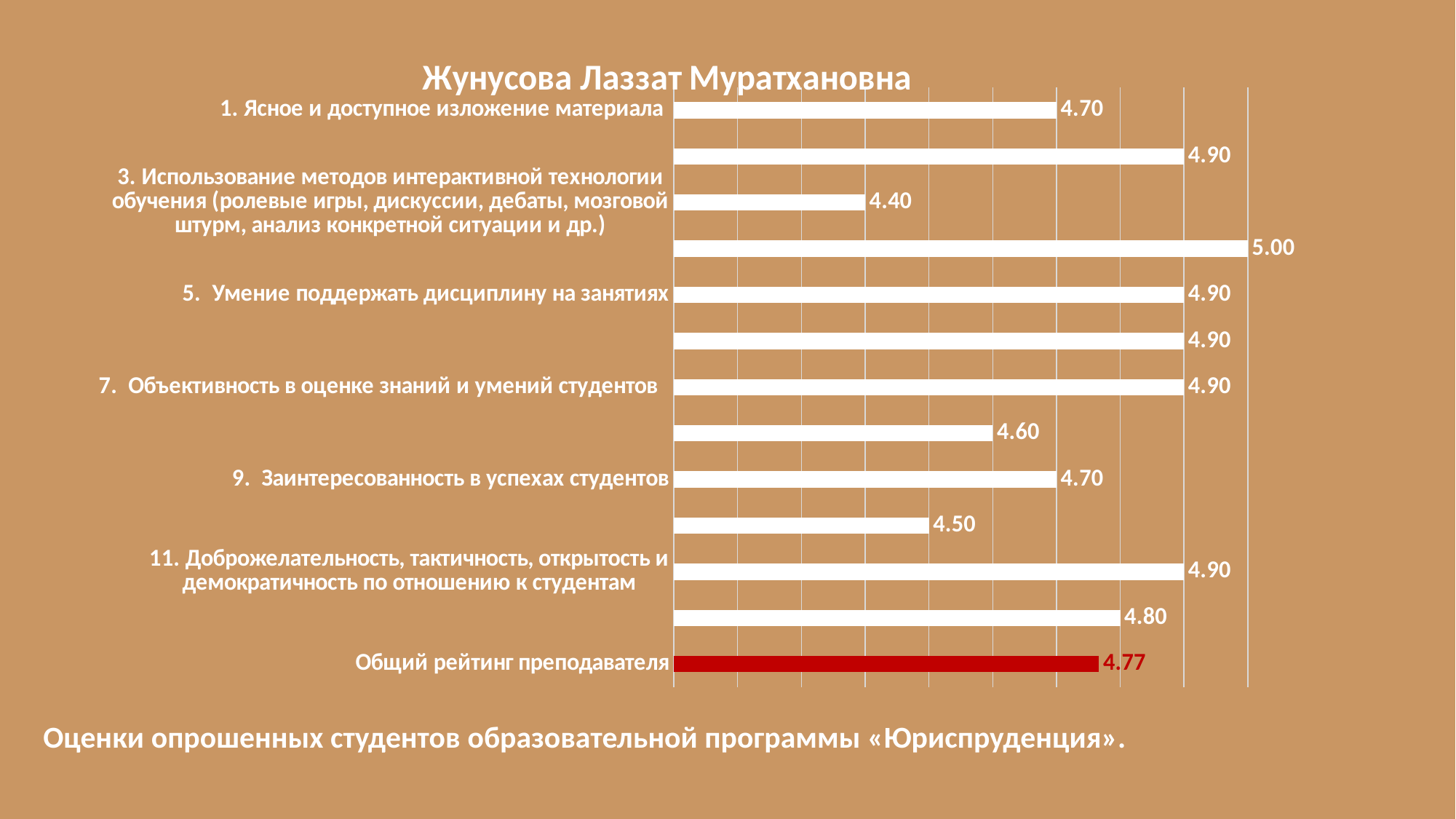
What is the difference between the values for category 5 (Умение поддержать дисциплину на занятиях) and category 3 (Использование методов интерактивной технологии обучения)? 0.50 Which labelled category has the lowest value? 3. Использование методов интерактивной технологии обучения What is the value for "5. Умение поддержать дисциплину на занятиях"? 4.90 How many bars are plotted in the chart? 13 Which is larger: the value for category 1 (Ясное и доступное изложение материала) or category 3 (Использование методов интерактивной технологии обучения)? 1. Ясное и доступное изложение материала What is the value for "Общий рейтинг преподавателя"? 4.77 What kind of chart is shown on the slide? Bar chart What is the value for "3. Использование методов интерактивной технологии обучения"? 4.40 What is the title of the chart? Жунусова Лаззат Муратхановна What colour is the bar for "Общий рейтинг преподавателя"? Red What is the value for "1. Ясное и доступное изложение материала"? 4.70 What is the value for "9. Заинтересованность в успехах студентов"? 4.70